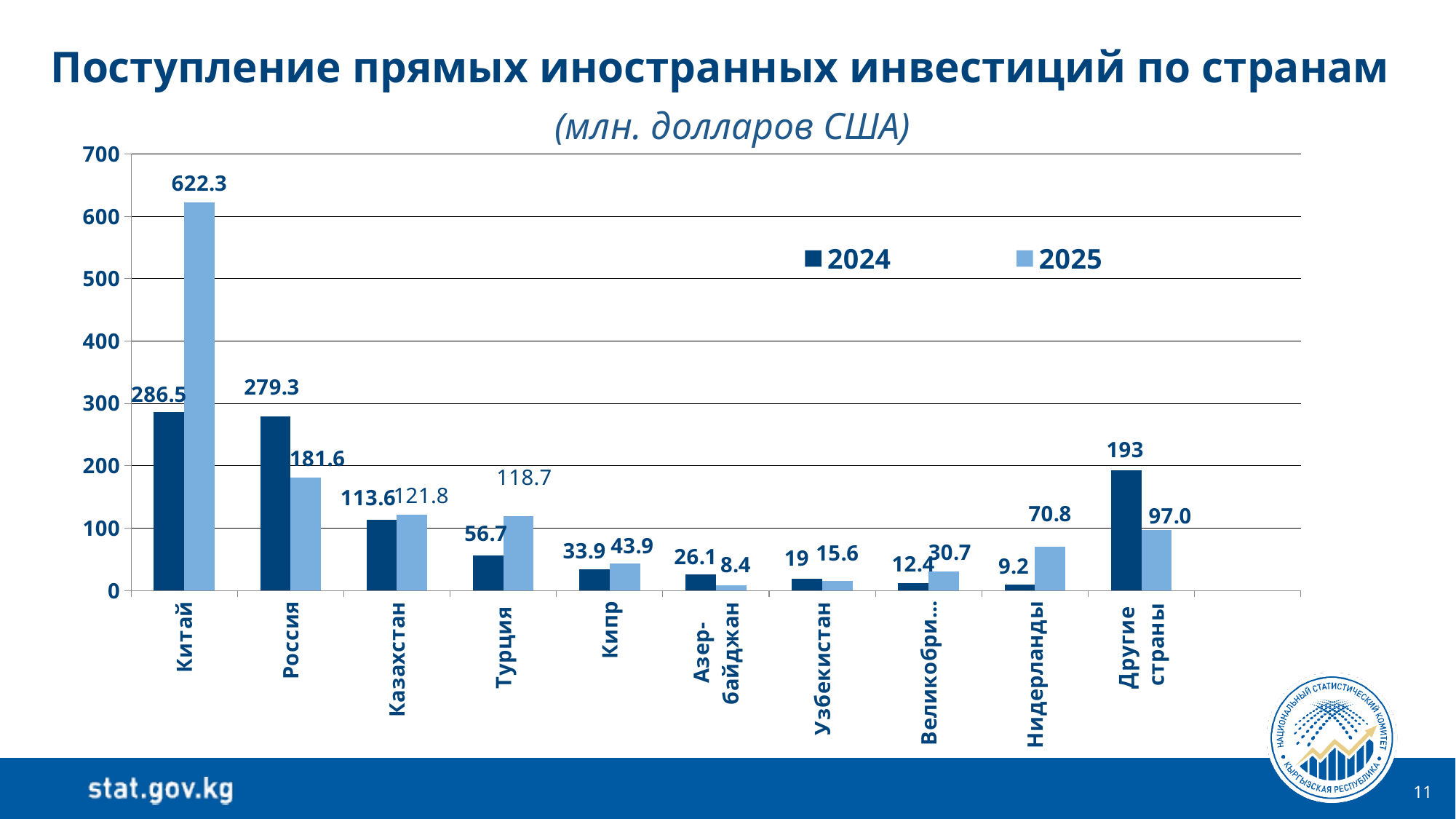
What is the 2024 value for Другие страны? 193 How many categories are shown on the x axis? 10 What is the 2025 value for Китай? 622.3 What is the 2024 value for Россия? 279.3 What is the difference between the 2025 and 2024 values for Китай? 335.8 What kind of chart is shown on the slide? Bar chart What unit is given in the chart subtitle? млн. долларов США Which is larger for Турция: the 2024 value or the 2025 value? 2025 Which country has the highest 2025 value? Китай What is the 2025 value for Нидерланды? 70.8 Which category has the lowest 2024 value? Нидерланды How many series does the legend list? 2